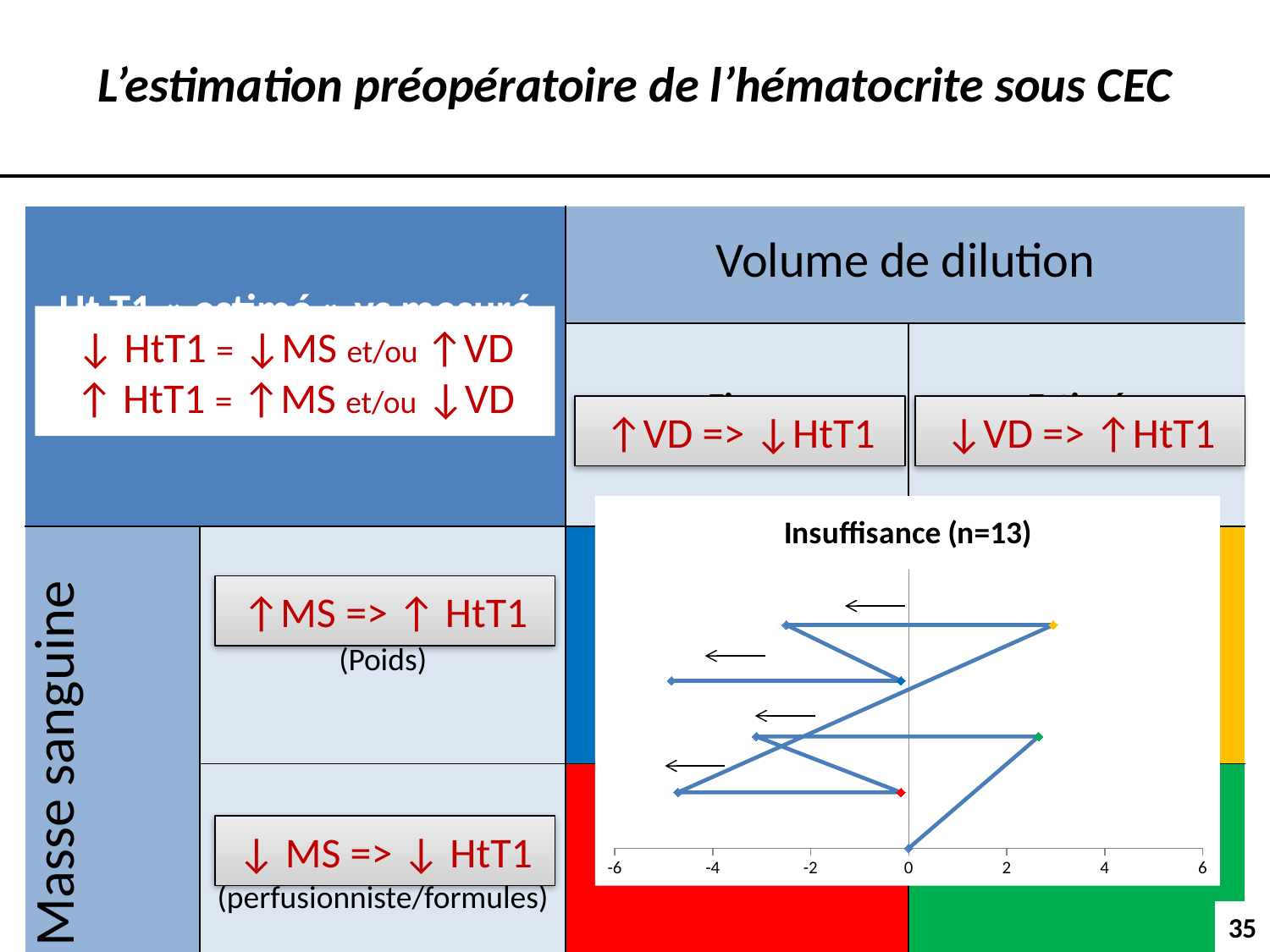
What is the highest value shown on the x axis of the chart? 6 In which direction do the arrows drawn on the chart point? left At which x-axis value does the bottom point of the line on the chart sit? 0 What is the title of the chart on the slide? Insuffisance (n=13) Is the value of the leftmost point on the chart greater or less than -4? less What kind of chart is shown on the slide? line chart Is the value of the rightmost point on the chart greater or less than 2? greater What is the lowest value shown on the x axis of the chart? -6